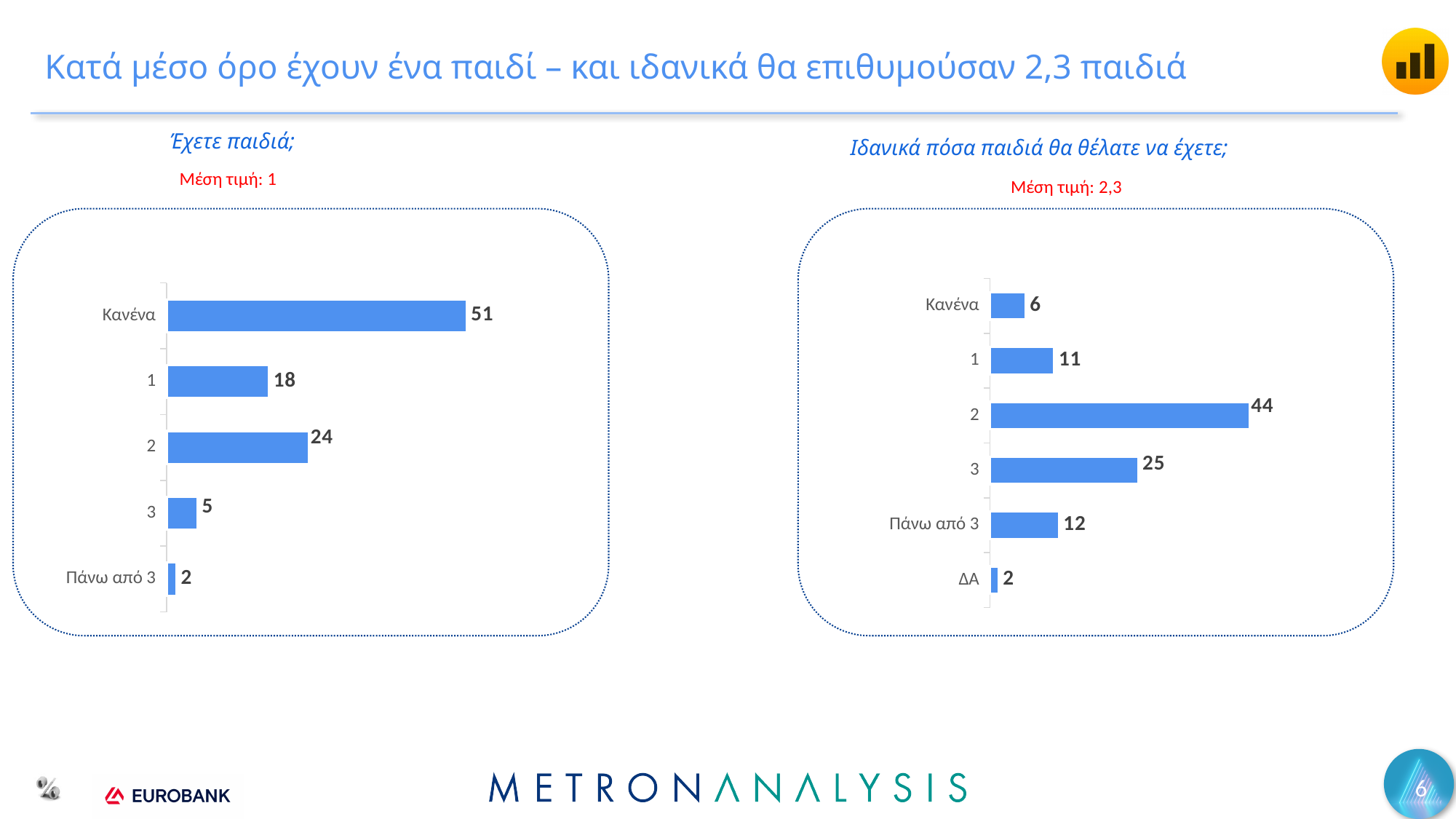
In the right chart ('Ιδανικά πόσα παιδιά θα θέλατε να έχετε;'), which category has the highest value? 2 In the right chart ('Ιδανικά πόσα παιδιά θα θέλατε να έχετε;'), what is the value for 'ΔΑ'? 2 In the left chart ('Έχετε παιδιά;'), which category has the lowest value? Πάνω από 3 How many categories does the left chart ('Έχετε παιδιά;') show? 5 In the right chart ('Ιδανικά πόσα παιδιά θα θέλατε να έχετε;'), what is the value for '2'? 44 How many categories does the right chart ('Ιδανικά πόσα παιδιά θα θέλατε να έχετε;') show? 6 In the left chart ('Έχετε παιδιά;'), what is the value for 'Κανένα'? 51 In the left chart ('Έχετε παιδιά;'), what is the difference between the values for '2' and '1'? 6 What is the mean value ('Μέση τιμή') shown above the right chart ('Ιδανικά πόσα παιδιά θα θέλατε να έχετε;')? 2,3 In the right chart ('Ιδανικά πόσα παιδιά θα θέλατε να έχετε;'), what is the difference between the values for '2' and '3'? 19 What kind of chart is the left chart ('Έχετε παιδιά;')? Bar chart In the right chart ('Ιδανικά πόσα παιδιά θα θέλατε να έχετε;'), which is larger: the value for '3' or the value for 'Πάνω από 3'? 3